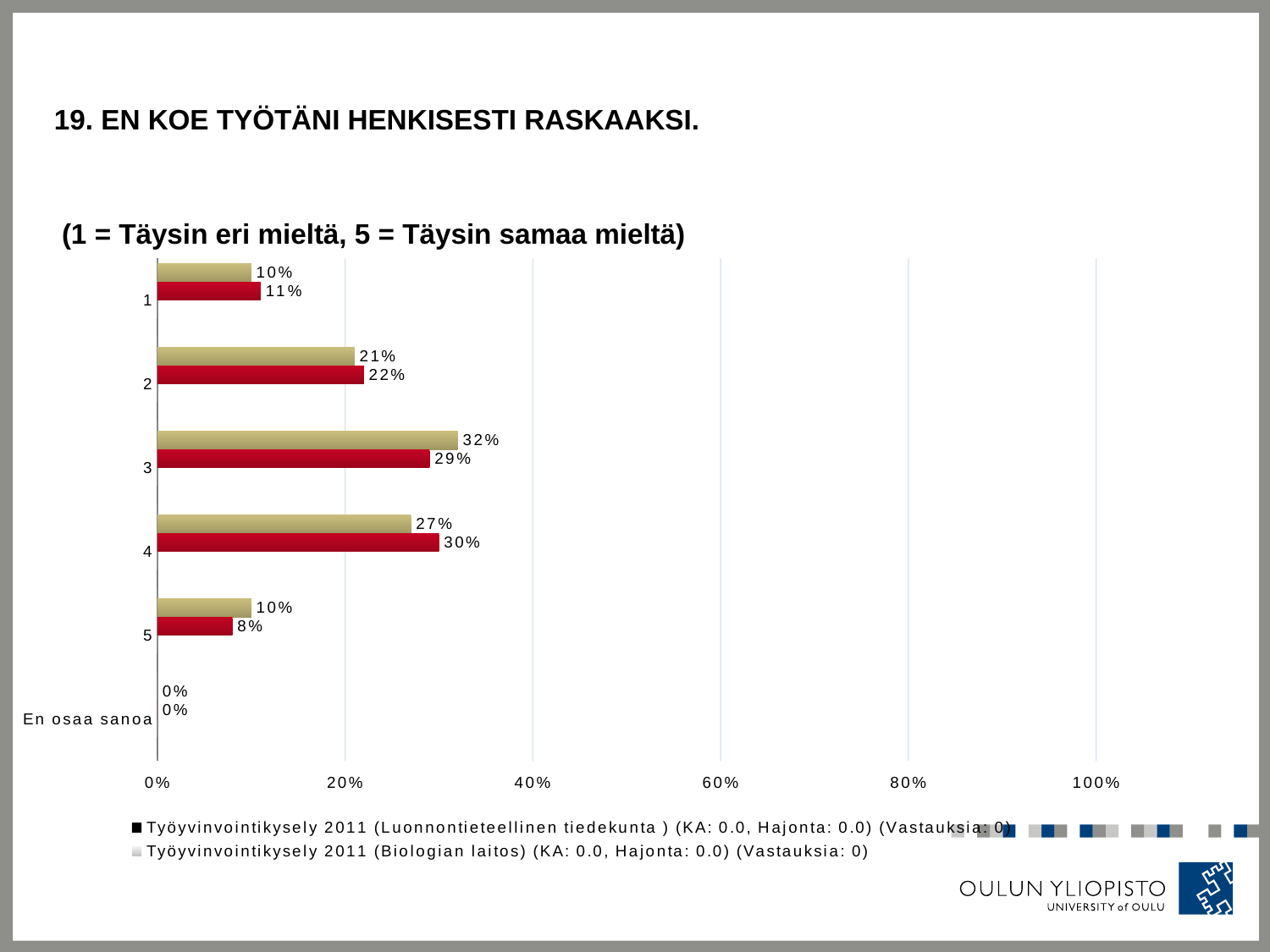
What is the value of the tan bar for category 3? 32% For category 3, how many percentage points higher is the tan bar than the red bar? 3 percentage points How many series does the legend list? 2 What is the value of the red bar for category 4? 30% What is the value of the red bar for category 1? 11% Among categories 1 to 5, which has the lowest red bar? 5 Which category has the highest red bar? 4 What kind of chart is shown on the slide? bar chart Which category has the highest tan bar? 3 For category 5, which bar is larger, the tan bar or the red bar? the tan bar How many categories are shown on the vertical axis of the chart? 6 Is the value of the red bar for category 2 greater or less than 20%? greater